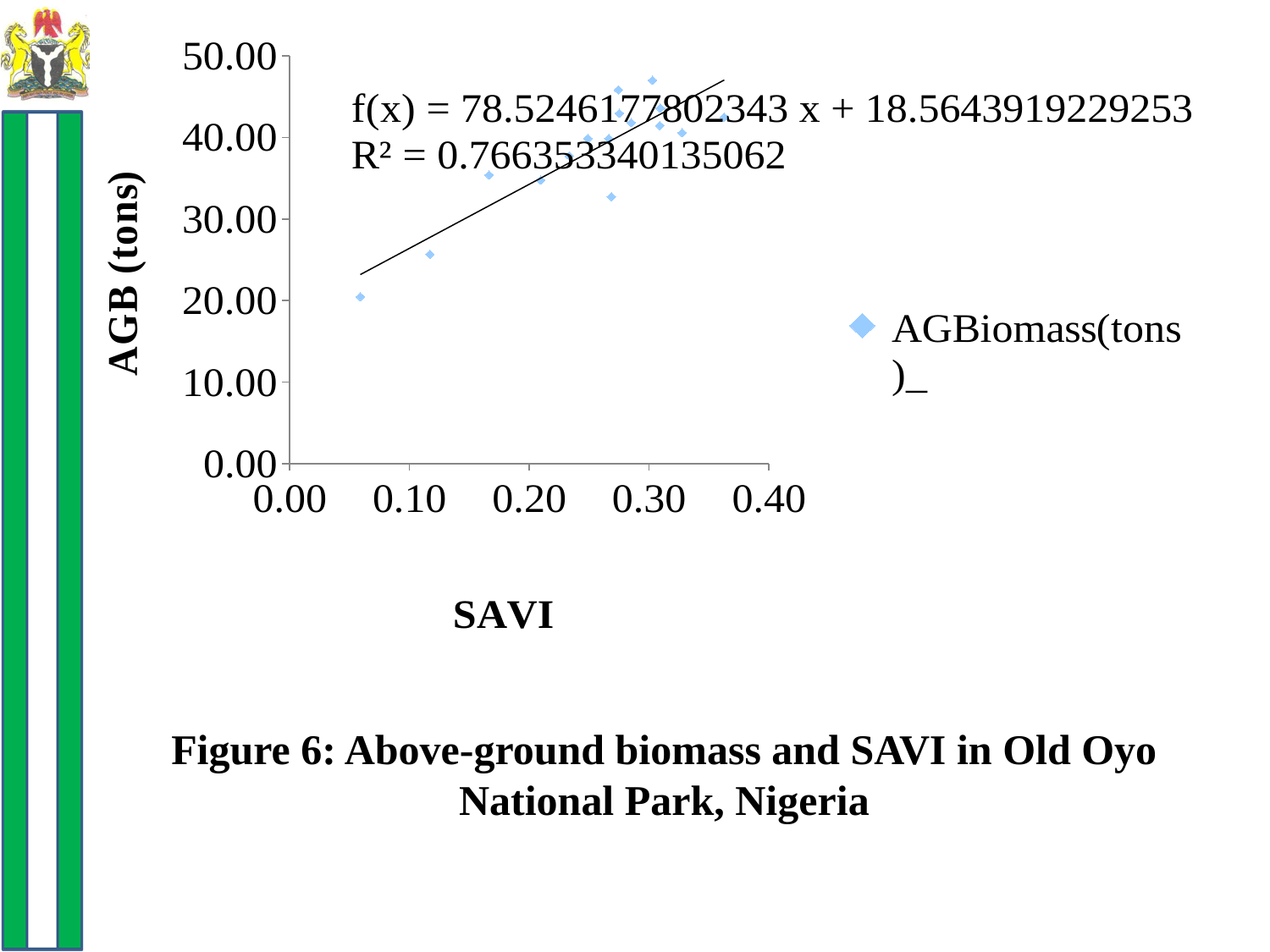
How many series does the legend list? 1 Is the AGB value for the point at SAVI of about 0.12 greater or less than 30? less What kind of chart is shown on the slide? scatter chart What is the intercept of the fitted line f(x) printed on the chart? 18.5643919229253 What is the legend entry for the plotted series? AGBiomass(tons)_ What is the slope of the fitted line f(x) printed on the chart? 78.5246177802343 What R² value is printed on the chart? R² = 0.766353340135062 Is the AGB value for the point with the highest SAVI greater or less than 40? greater Is the AGB value of the highest point on the chart greater or less than 40? greater What is the title of the vertical axis? AGB (tons) As SAVI increases along the x axis, do the AGB values generally rise or fall? rise